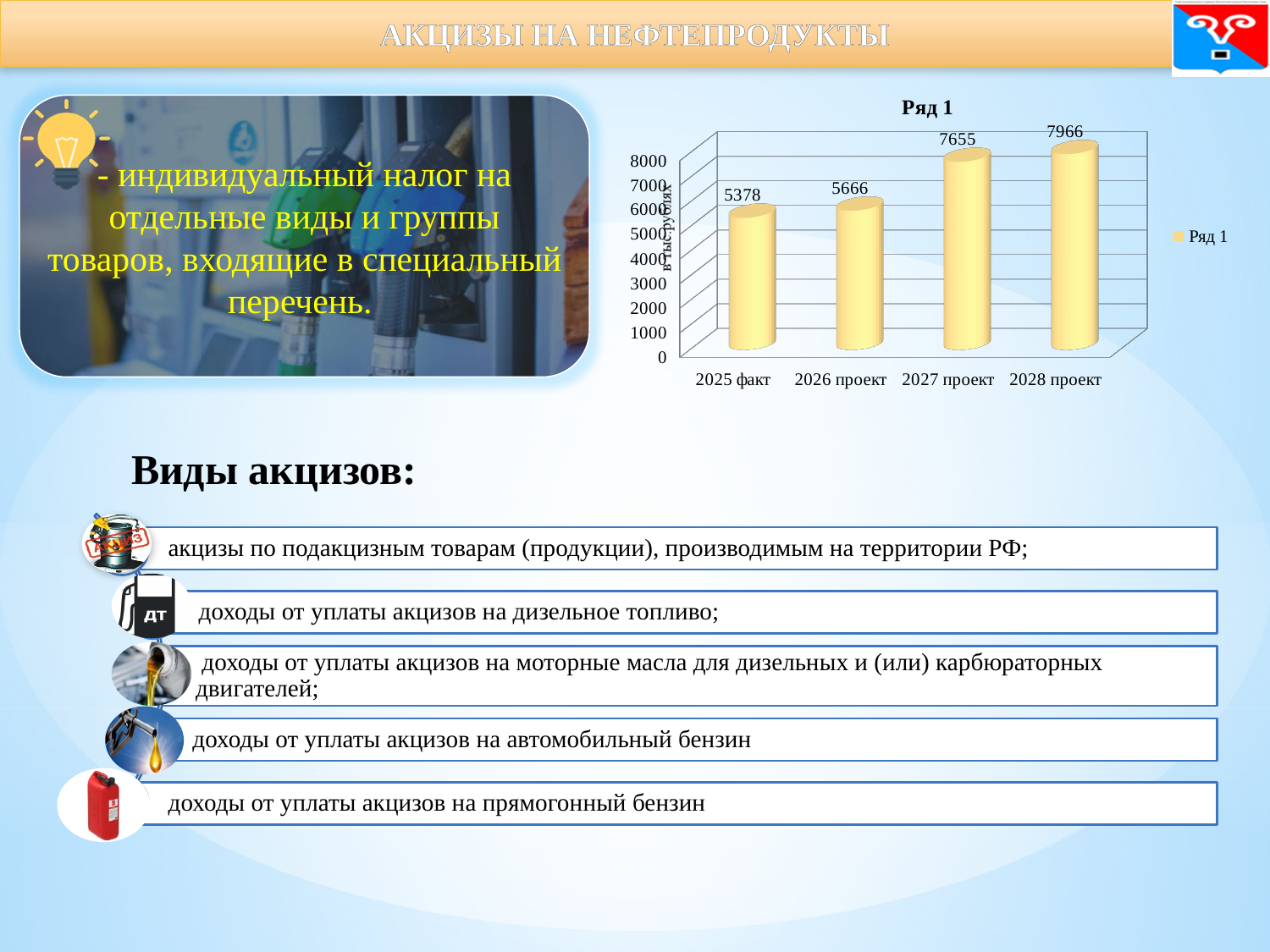
What is the difference between the values for 2028 проект and 2025 факт? 2588 Do the values rise or fall from 2025 факт to 2028 проект? rise What is the value for 2025 факт? 5378 How many categories are shown on the x axis? 4 Which category has the highest value? 2028 проект What is the difference between the values for 2027 проект and 2026 проект? 1989 What is the value for 2026 проект? 5666 What is the value for 2028 проект? 7966 Which category has the lowest value? 2025 факт Which is larger, the value for 2026 проект or the value for 2027 проект? 2027 проект What is the value for 2027 проект? 7655 What kind of chart is shown on the slide? bar chart